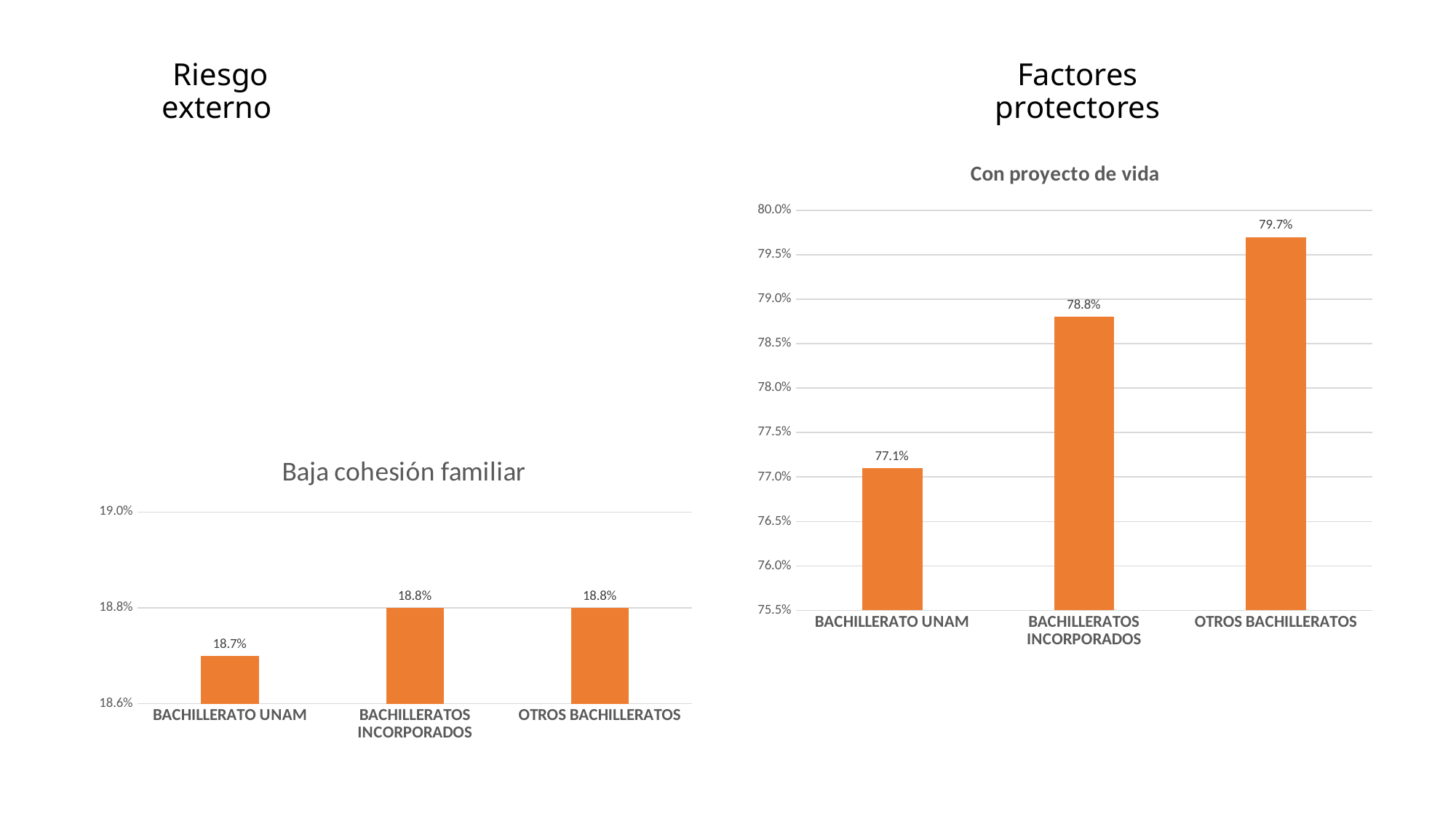
In the 'Con proyecto de vida' chart, which is larger, BACHILLERATOS INCORPORADOS or BACHILLERATO UNAM? BACHILLERATOS INCORPORADOS In the 'Baja cohesión familiar' chart, what is the value for BACHILLERATO UNAM? 18.7% In the 'Con proyecto de vida' chart, which category has the lowest value? BACHILLERATO UNAM In the 'Con proyecto de vida' chart, what is the value for OTROS BACHILLERATOS? 79.7% In the 'Con proyecto de vida' chart, what is the difference between OTROS BACHILLERATOS and BACHILLERATO UNAM? 2.6% In the 'Baja cohesión familiar' chart, which category has the lowest value? BACHILLERATO UNAM In the 'Con proyecto de vida' chart, which category has the highest value? OTROS BACHILLERATOS In the 'Baja cohesión familiar' chart, what is the value for OTROS BACHILLERATOS? 18.8% In the 'Con proyecto de vida' chart, do the values rise or fall from left to right? rise What kind of chart is the 'Con proyecto de vida' chart? bar chart In the 'Con proyecto de vida' chart, what is the value for BACHILLERATOS INCORPORADOS? 78.8% In the 'Baja cohesión familiar' chart, how many categories are shown? 3